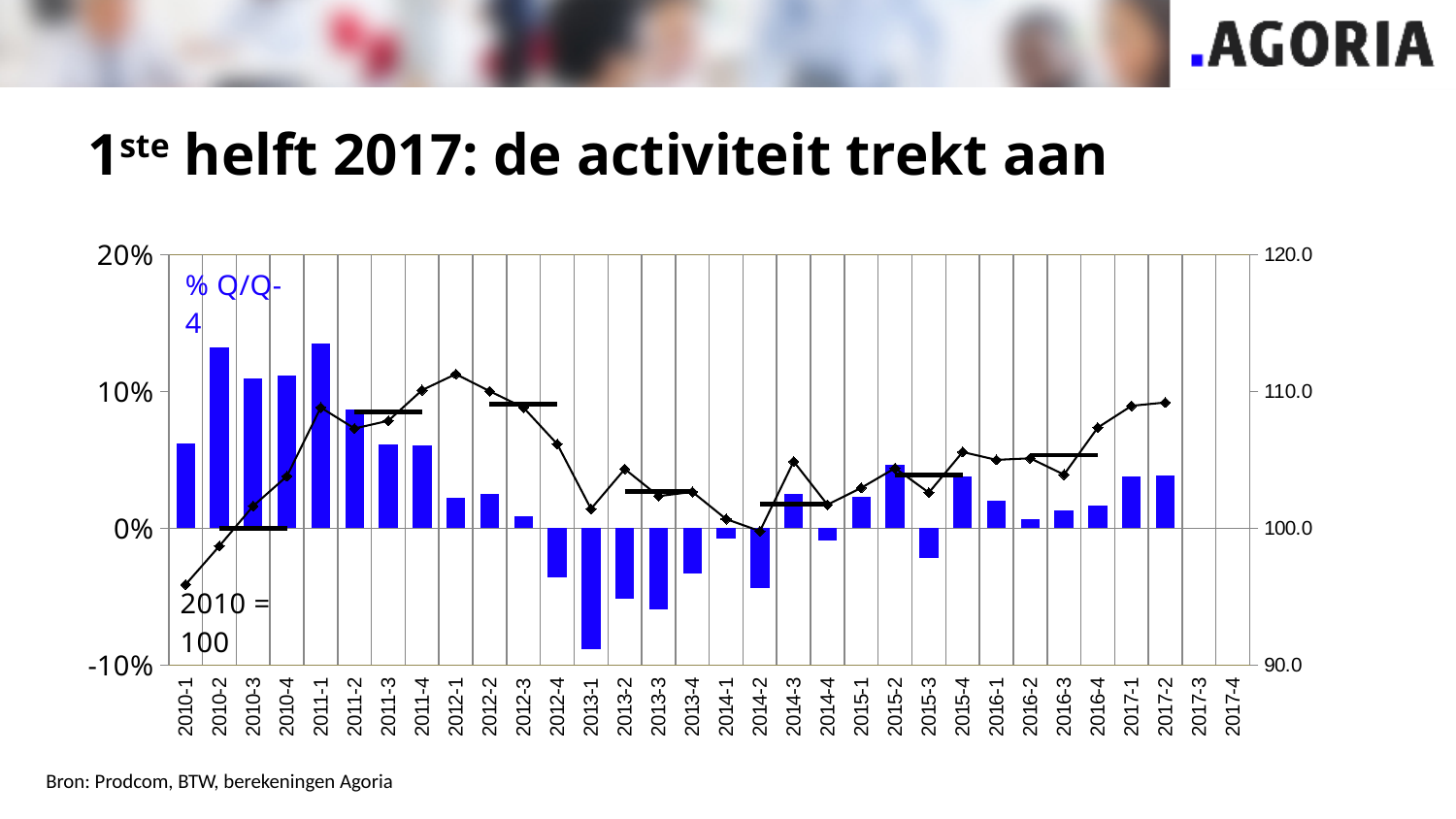
Is the bar value for 2010-2 greater or less than 10%? greater How many quarter labels are shown on the x axis? 32 Is the line (index) value for 2017-2 greater or less than 100.0? greater Which is lower, the bar for 2013-1 or the bar for 2013-3? 2013-1 Does the index line rise or fall from 2016-3 to 2017-2? rise Is the line (index) value for 2012-1 greater or less than 110.0? greater Which quarter has the lowest bar (most negative % Q/Q-4 value)? 2013-1 Which quarter has the highest point on the index line? 2012-1 What kind of chart is shown on the slide? A combined bar and line chart What base year note is printed on the chart for the index line? 2010 = 100